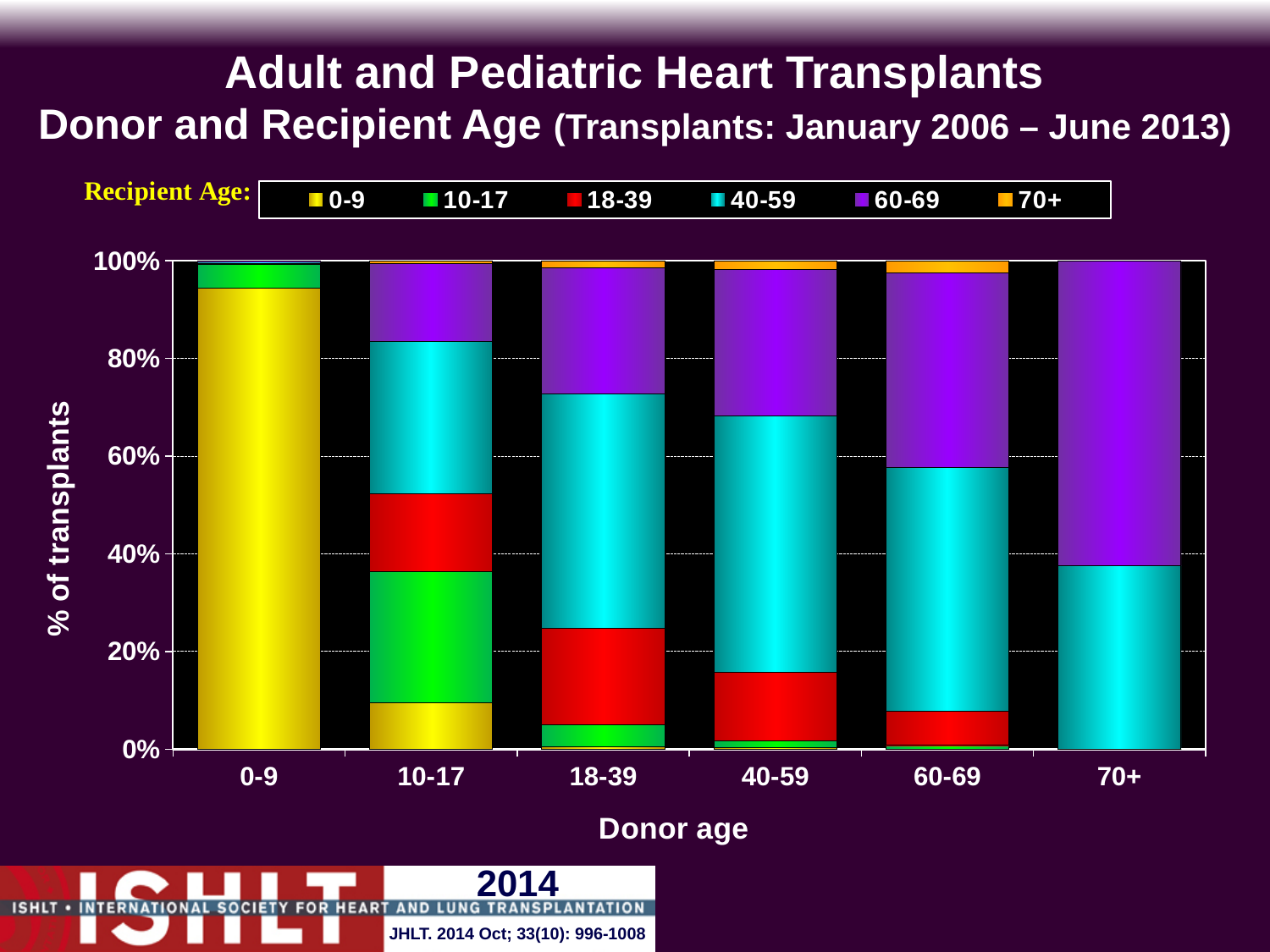
Is the share of recipients aged 0-9 for donor age 0-9 greater or less than 80%? greater For donor age 10-17, which recipient age group has the larger share: 40-59 or 18-39? 40-59 For donor age 70+, which recipient age group has the larger share: 60-69 or 40-59? 60-69 How many recipient age groups does the legend list? 6 How many donor age groups are shown on the x axis? 6 What is the title of the y axis? % of transplants What kind of chart is shown on the slide? Stacked bar chart Is the share of recipients aged 10-17 for donor age 10-17 greater or less than 20%? greater Is the share of recipients aged 40-59 for donor age 70+ greater or less than 40%? less What is the title of the x axis? Donor age Does the share of recipients aged 60-69 rise or fall as donor age increases along the x axis? rise